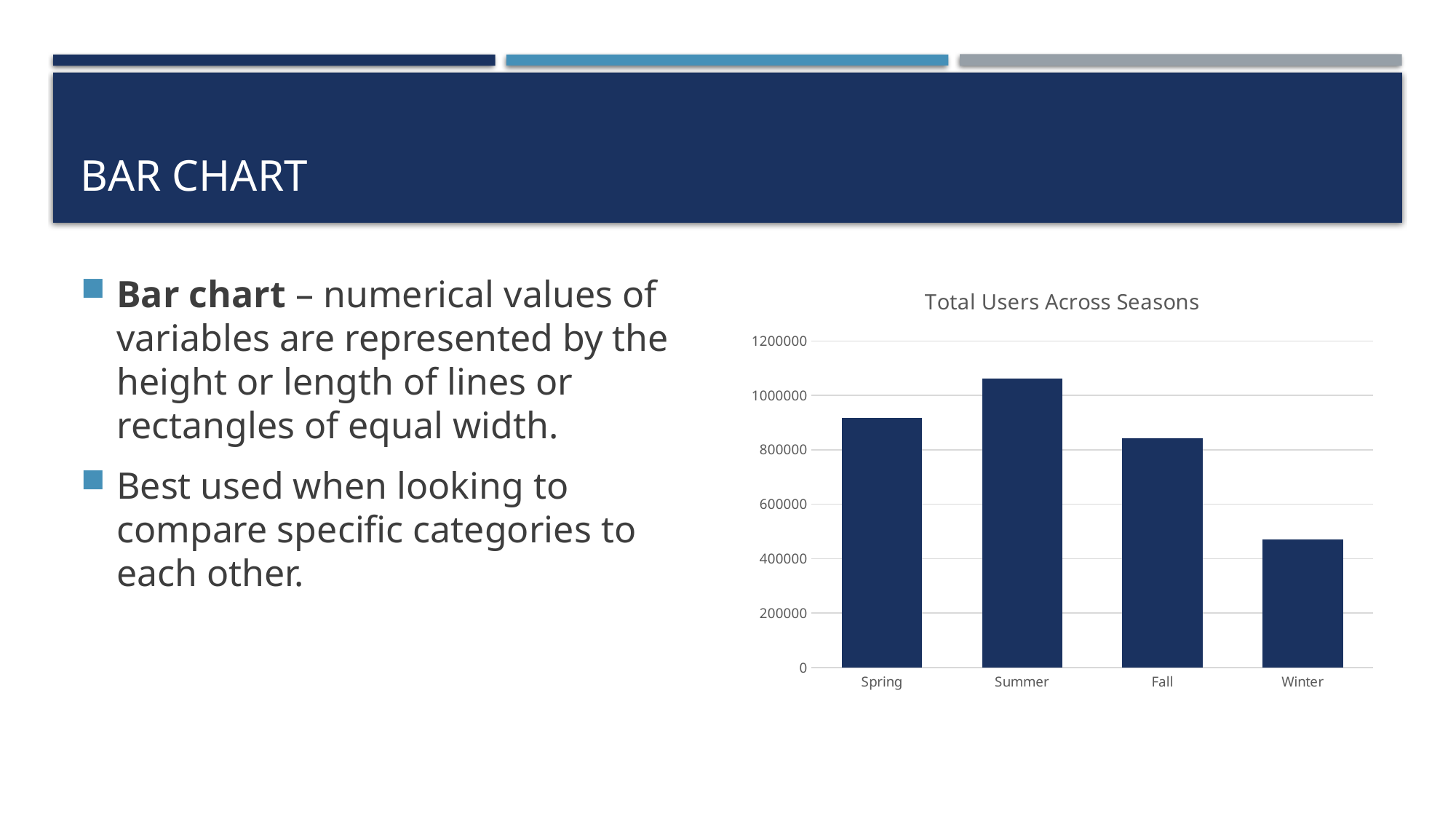
Which season has the lowest total users? Winter Is the value for Summer greater or less than 1000000? greater How many seasons are shown on the x axis of the chart? 4 Which has more total users, Spring or Fall? Spring Which has more total users, Winter or Summer? Summer Which season has the highest total users? Summer Is the value for Spring greater or less than 800000? greater What is the highest value shown on the y axis of the chart? 1200000 Is the value for Fall greater or less than 1000000? less What is the title of the chart? Total Users Across Seasons What kind of chart is shown on the slide? bar chart